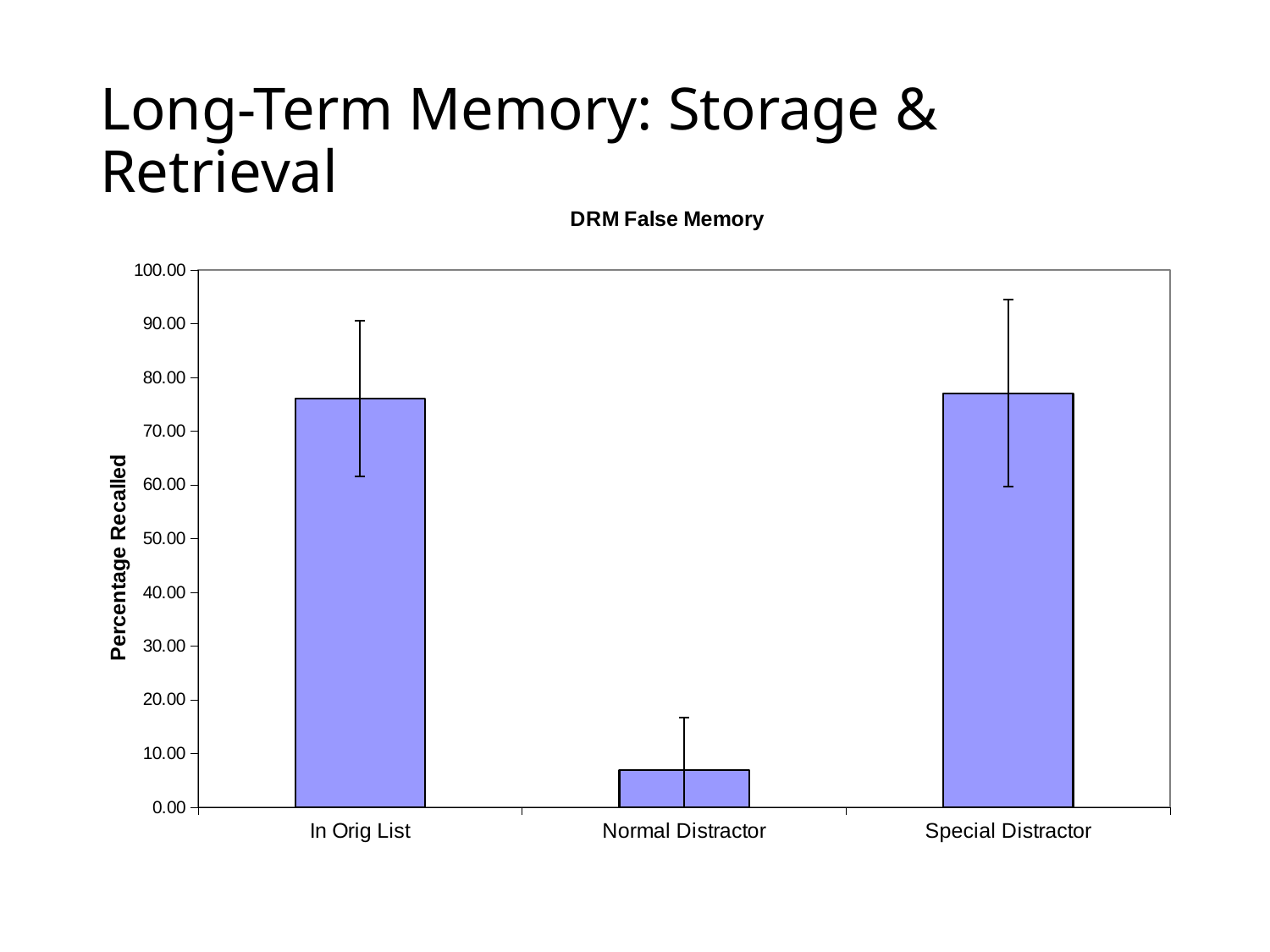
Is the value for In Orig List greater or less than 90.00? less Which is larger, the value for In Orig List or the value for Normal Distractor? In Orig List Which category has the lowest percentage recalled? Normal Distractor Which is larger, the value for Normal Distractor or the value for Special Distractor? Special Distractor Is the value for Special Distractor greater or less than 80.00? less Is the value for Normal Distractor greater or less than 10.00? less What is the title of the chart? DRM False Memory What is the label on the vertical axis of the chart? Percentage Recalled How many categories are shown on the x axis of the chart? 3 What kind of chart is shown on the slide? bar chart